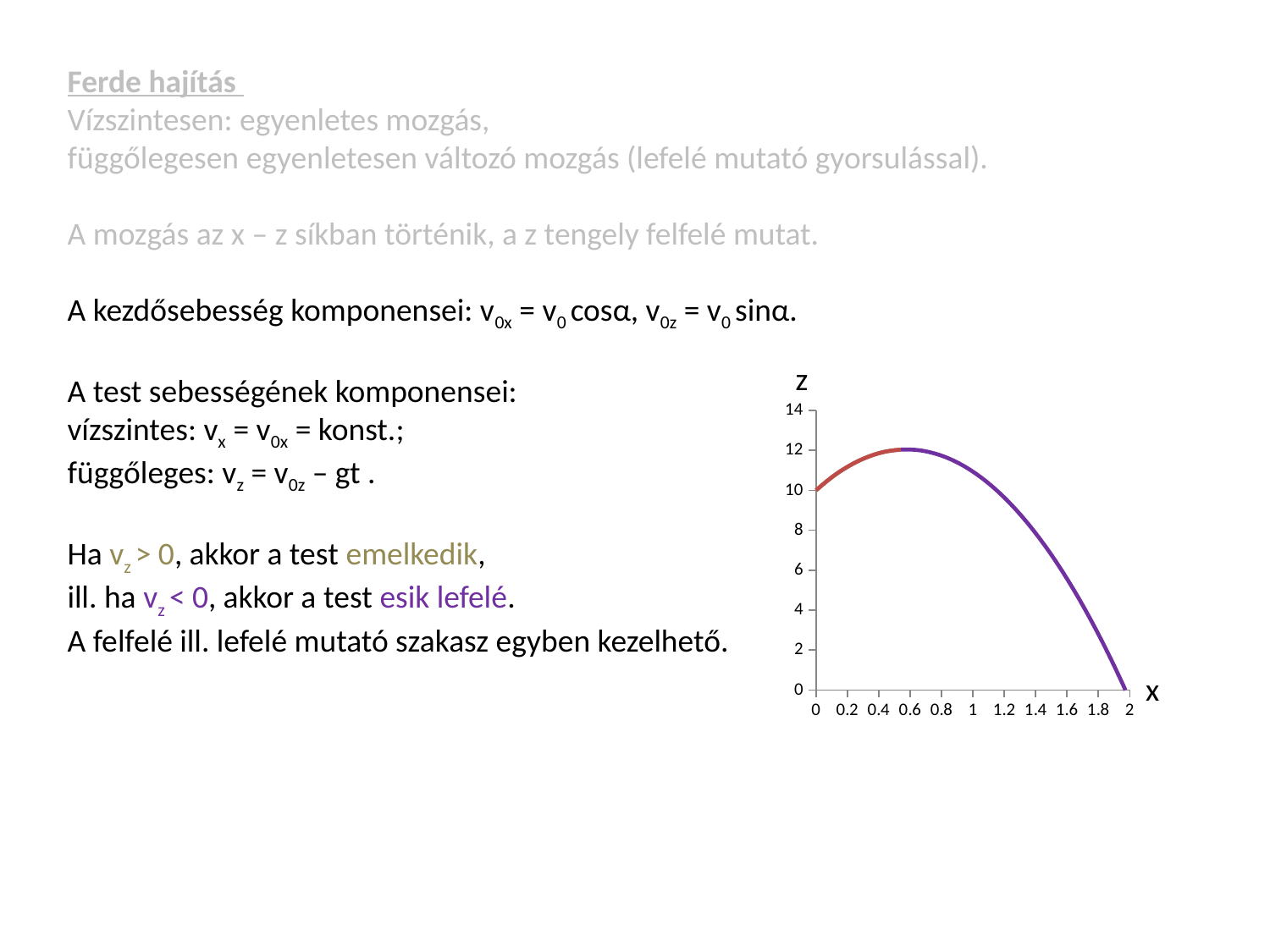
Is the value of z at x = 1.8 greater or less than 4? less What is the difference between the value of z at x = 0 and at x = 2? 10 Which is larger, the value of z at x = 0 or at x = 2? x = 0 Is the highest point of the curve greater or less than 10? greater What kind of chart is shown on the slide? line chart Is the value of z at x = 1 greater or less than 10? greater What are the labels of the horizontal and vertical axes of the chart? x and z What is the value of z at x = 2 on the chart? 0 What is the value of z at x = 0 on the chart? 10 How does the curve behave as x increases from 0 to 2? rises then falls What is the highest value shown on the vertical axis of the chart? 14